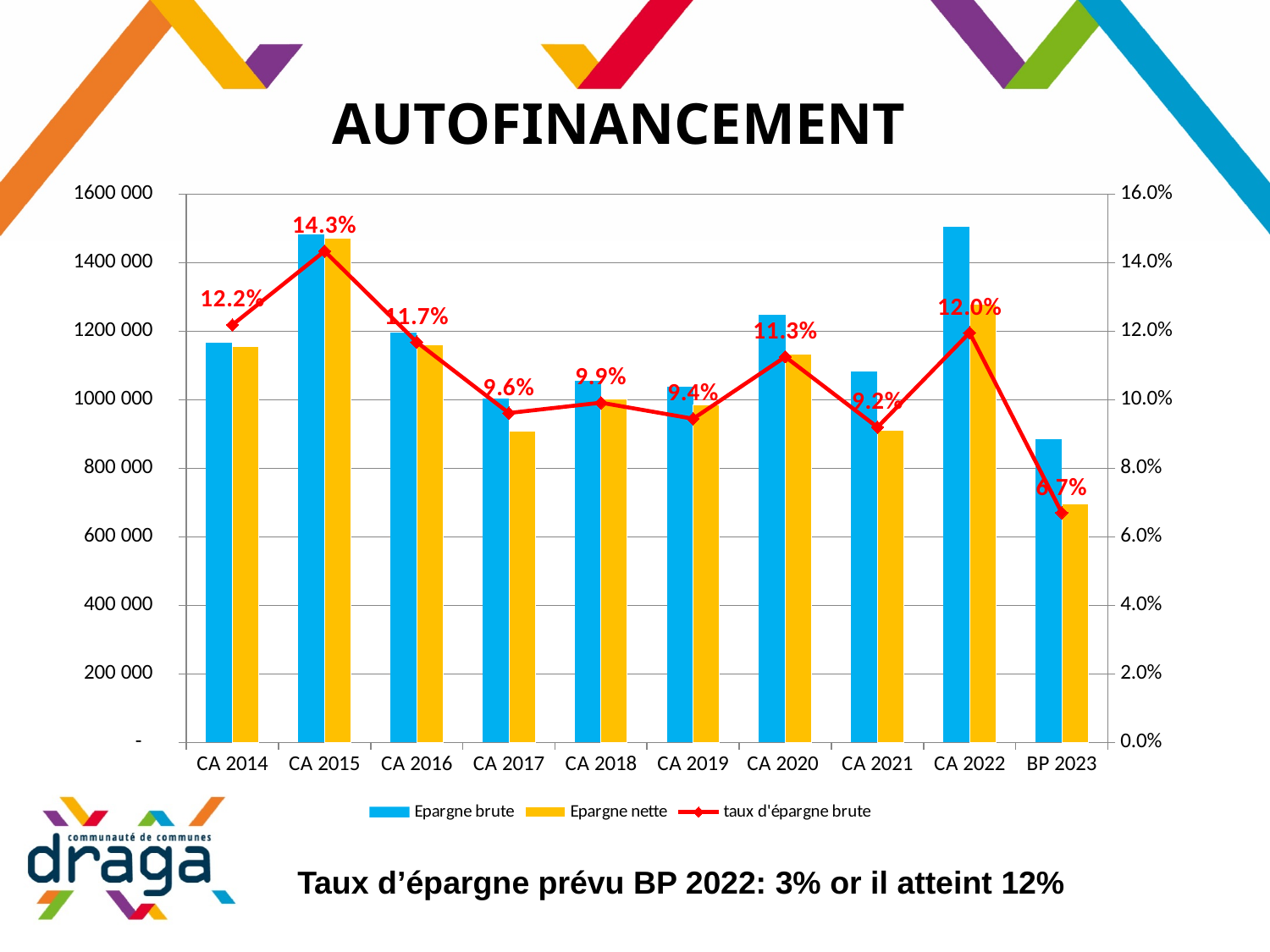
Is the Epargne nette value for BP 2023 greater or less than 800 000? less Which year has the lowest taux d'épargne brute? BP 2023 What is the taux d'épargne brute for CA 2015? 14.3% What is the difference between the taux d'épargne brute for CA 2022 and BP 2023? 5.3% Is the Epargne brute value for CA 2022 greater or less than 1400 000? greater What is the taux d'épargne brute for CA 2020? 11.3% How many years are shown on the x axis? 10 What is the taux d'épargne brute for BP 2023? 6.7% Which is larger, the taux d'épargne brute for CA 2014 or for CA 2016? CA 2014 What kind of chart is shown on the slide? Combined bar and line chart How many series does the legend list? 3 Which year has the highest taux d'épargne brute? CA 2015